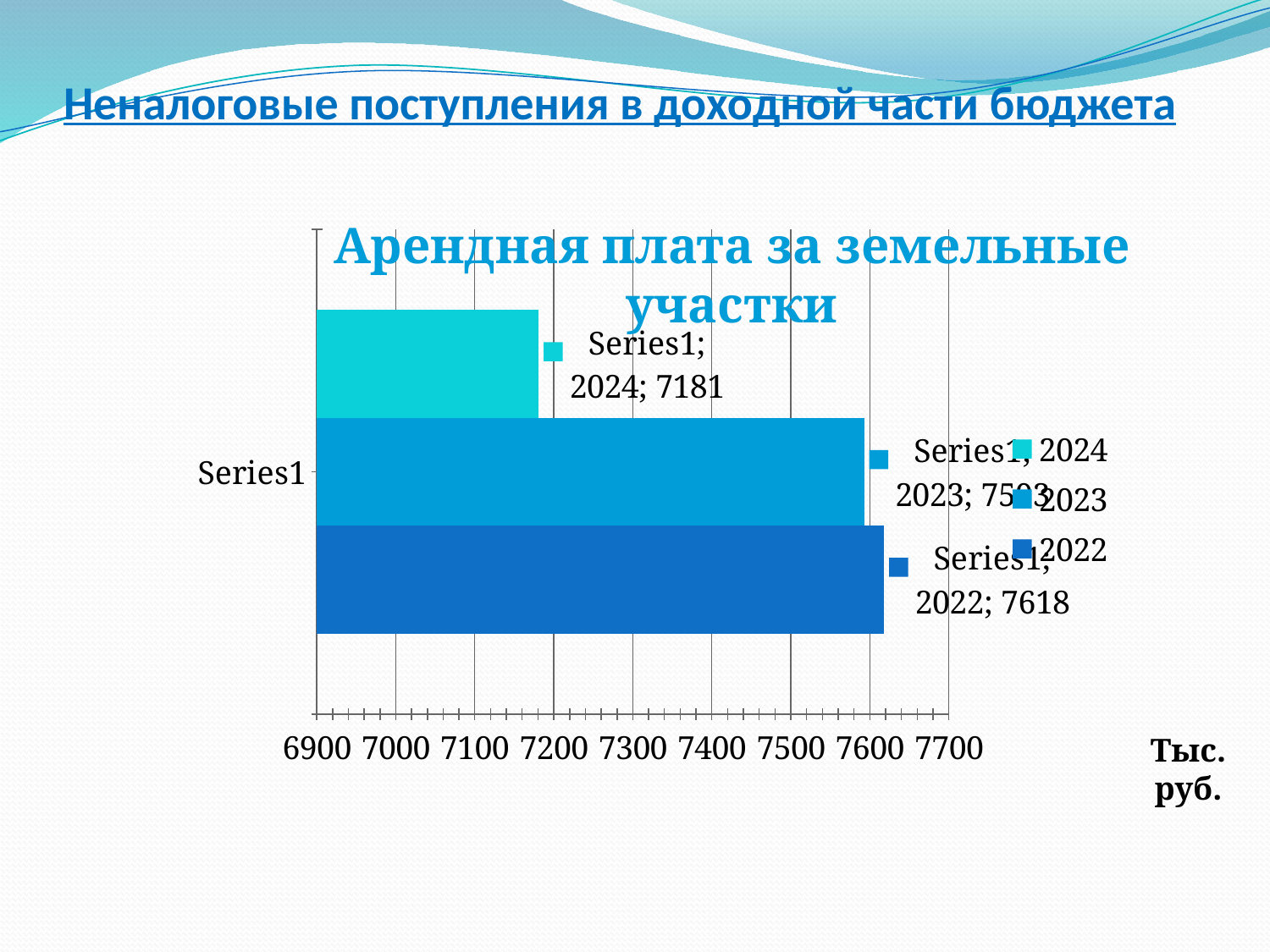
How many bars are plotted in the chart? 3 What type of chart is shown on the slide? bar chart Which year has the highest value? 2022 What is the title of the chart? Арендная плата за земельные участки Which year has the lowest value? 2024 What is the difference between the values for 2022 and 2024? 437 Is the value for 2023 greater or less than 7500? greater What is the value for 2022? 7618 Which is larger, the value for 2022 or the value for 2024? 2022 How many entries does the legend list? 3 What is the value for 2024? 7181 Is the value for 2024 greater or less than 7300? less